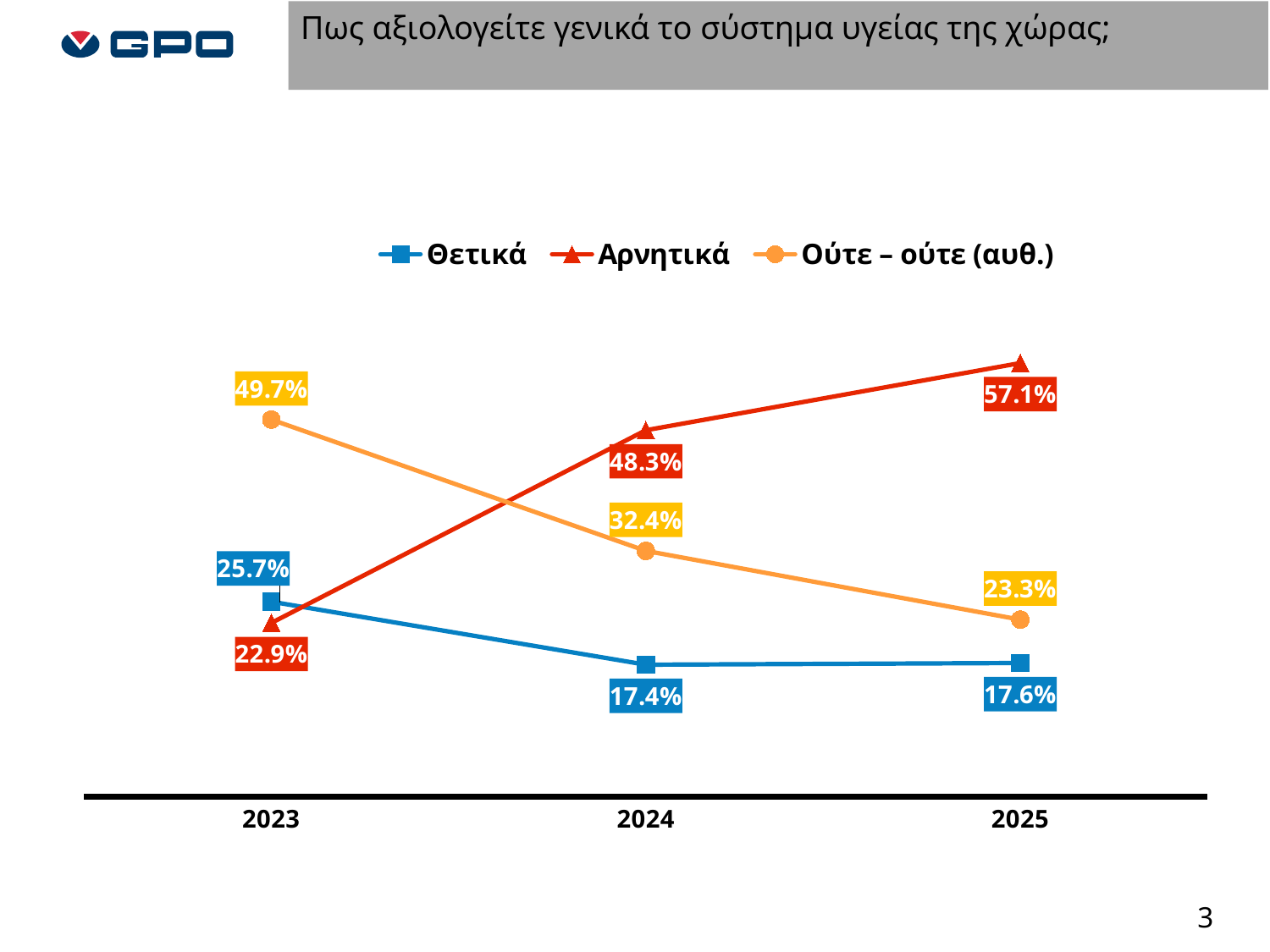
What is the value for Ούτε – ούτε (αυθ.) in 2024? 32.4% What is the difference between the Αρνητικά value in 2025 and in 2023? 34.2% How many years are shown on the x axis? 3 What is the value for Αρνητικά in 2025? 57.1% Does the Ούτε – ούτε (αυθ.) series rise or fall from 2023 to 2025? Fall How many series does the legend list? 3 What colour is the line for the Αρνητικά series? Red Which is larger in 2023: Ούτε – ούτε (αυθ.) or Αρνητικά? Ούτε – ούτε (αυθ.) In which year is the Θετικά series lowest? 2024 What is the value for Θετικά in 2023? 25.7% What kind of chart is shown on the slide? Line chart In which year is the Αρνητικά series highest? 2025